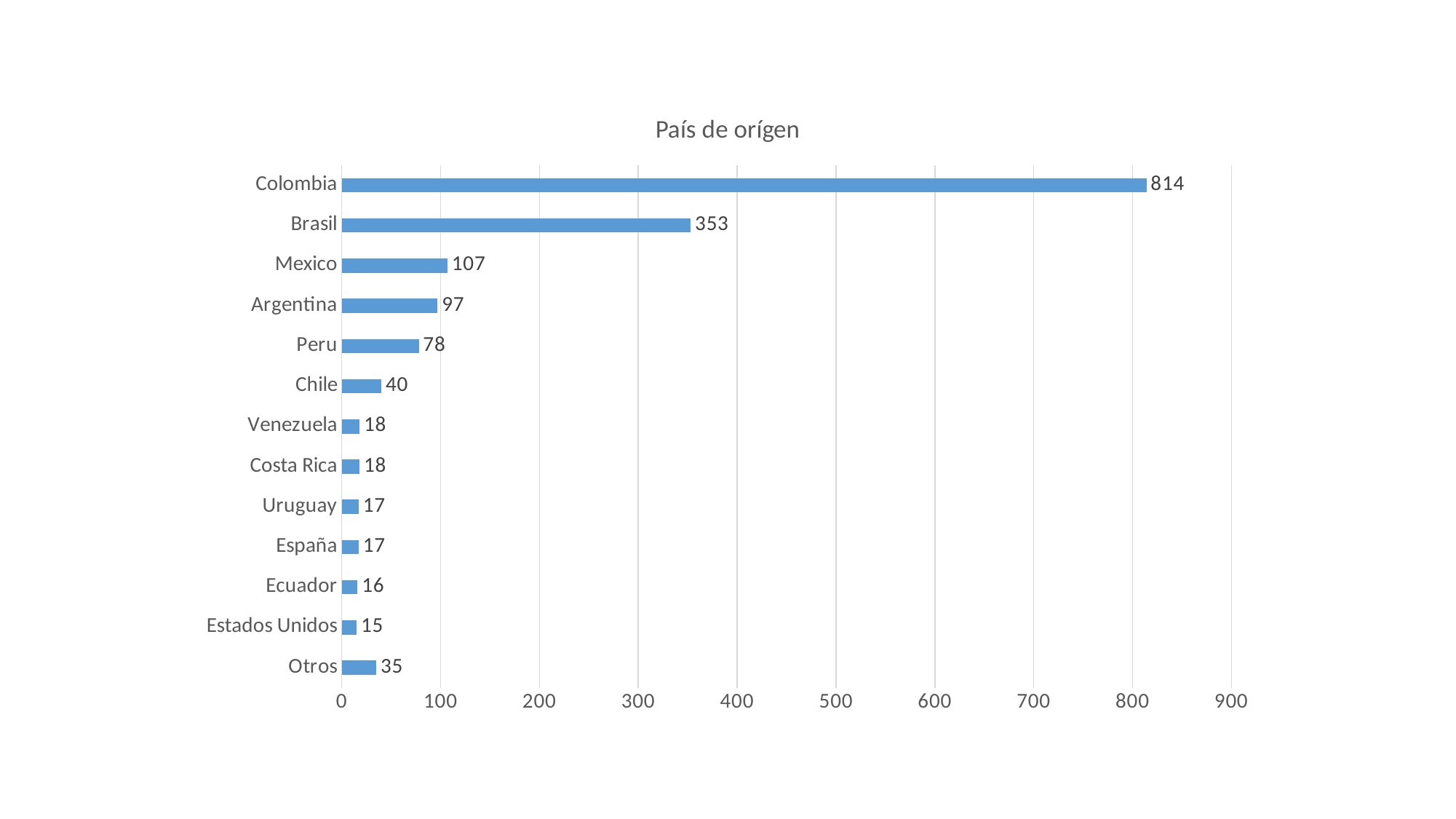
What is the value for Brasil? 353 Which country has the highest value? Colombia What is the difference between the values for Mexico and Argentina? 10 What is the value for Otros? 35 What is the value for Colombia? 814 How many categories are shown on the chart? 13 Which category has the lowest value? Estados Unidos What kind of chart is this? Bar chart What is the title of the chart? País de orígen What is the difference between the values for Colombia and Brasil? 461 What is the value for Peru? 78 Which is larger, the value for Chile or the value for Otros? Chile